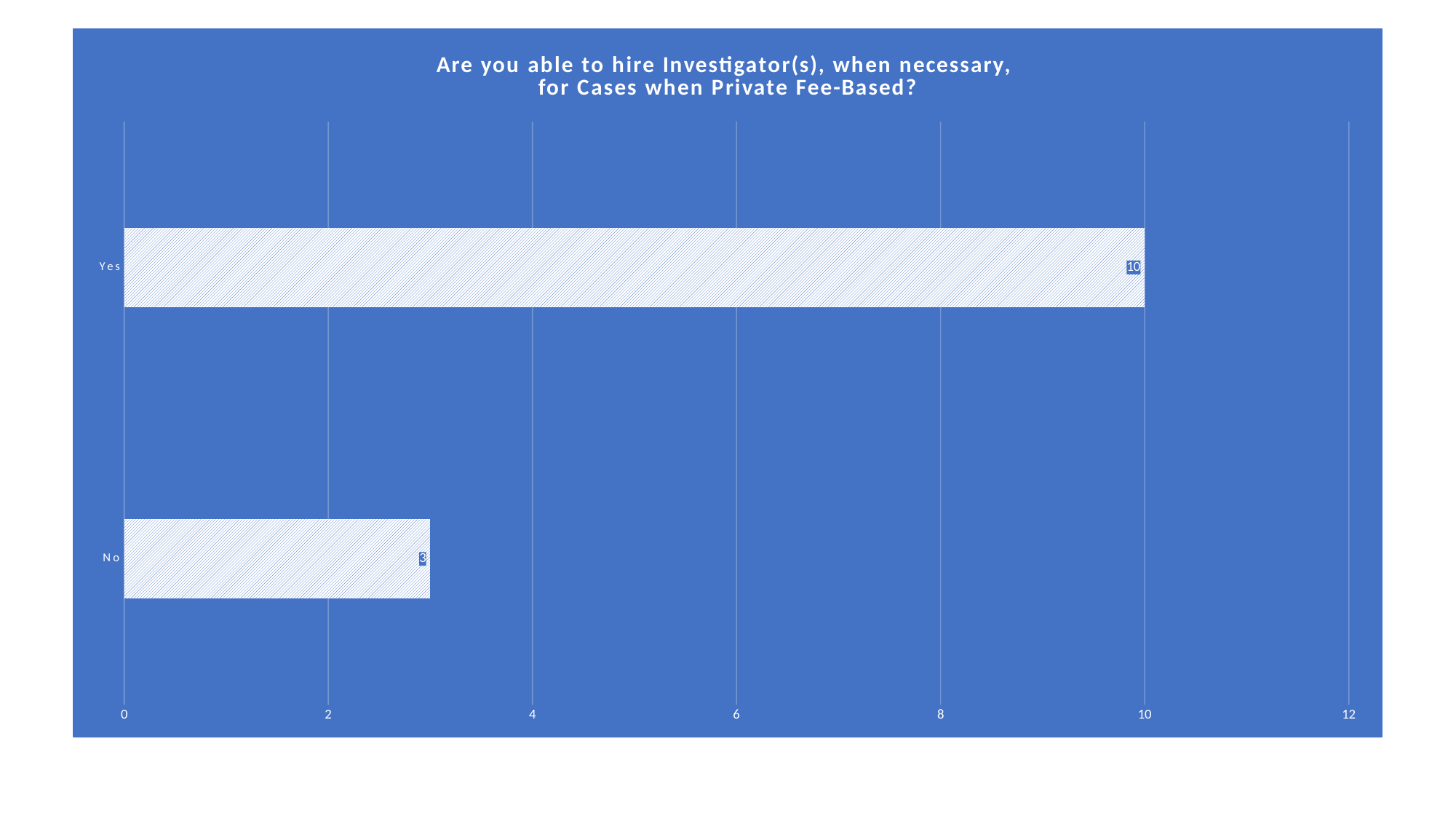
Which category has the highest value? Yes What is the difference between the values for Yes and No? 7 What is the value for Yes? 10 Which category has the lowest value? No What is the title of the chart? Are you able to hire Investigator(s), when necessary, for Cases when Private Fee-Based? Is the value for Yes greater or less than 8? greater Is the value for No greater or less than 4? less Which is larger, the value for Yes or the value for No? Yes What is the value for No? 3 What is the maximum value shown on the horizontal axis? 12 How many categories are shown in the chart? 2 What kind of chart is shown on the slide? bar chart